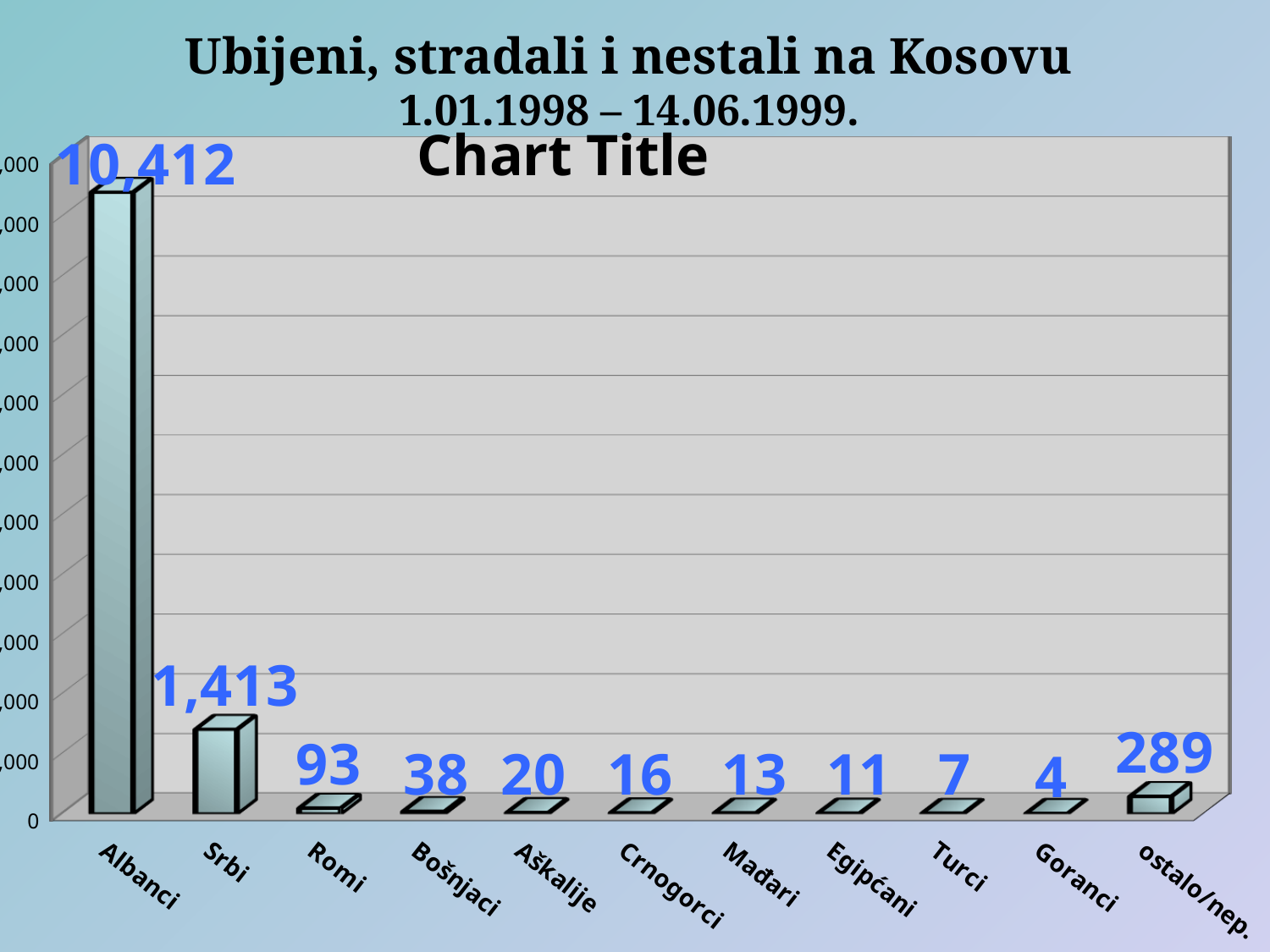
Which category has the highest value? Albanci What kind of chart is shown on the slide? bar chart Which category has the lowest value? Goranci What is the difference between the values for Albanci and Srbi? 8,999 What title is printed inside the chart area? Chart Title What is the value for ostalo/nep.? 289 What is the value for Albanci? 10,412 How many categories are shown on the x axis? 11 What is the value for Srbi? 1,413 Which is larger, the value for Romi or the value for ostalo/nep.? ostalo/nep. What is the value for Romi? 93 What is the difference between the values for Bošnjaci and Aškalije? 18